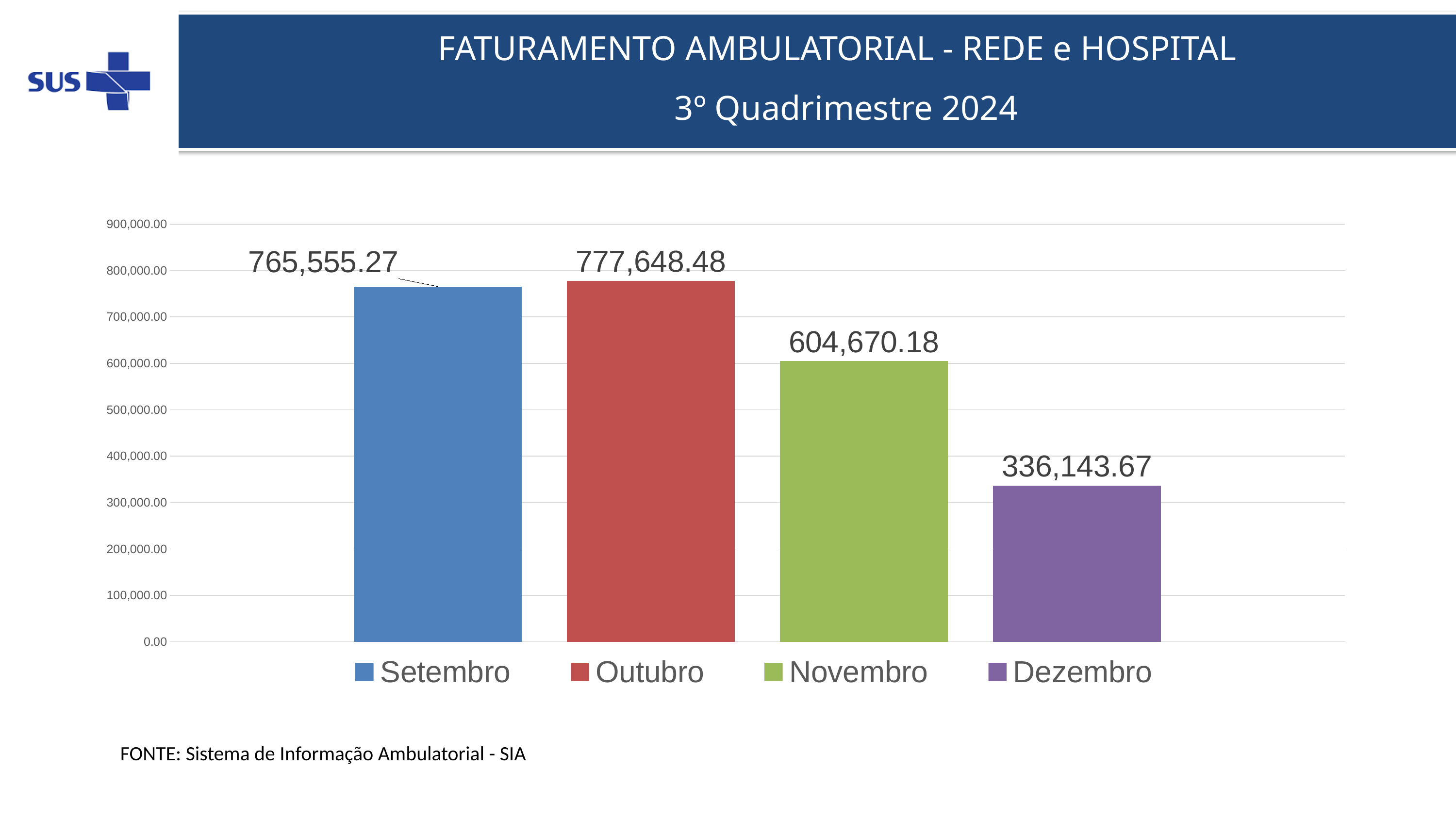
Which month has the highest value? Outubro What is the value for Outubro? 777,648.48 What is the value for Dezembro? 336,143.67 What is the value for Setembro? 765,555.27 What is the value for Novembro? 604,670.18 Which month has the lowest value? Dezembro What is the difference between the values for Outubro and Setembro? 12,093.21 How many bars are shown in the chart? 4 What is the difference between the values for Novembro and Dezembro? 268,526.51 Which is larger, the value for Setembro or the value for Novembro? Setembro Is the value for Dezembro greater or less than 400,000.00? less What kind of chart is shown on the slide? bar chart